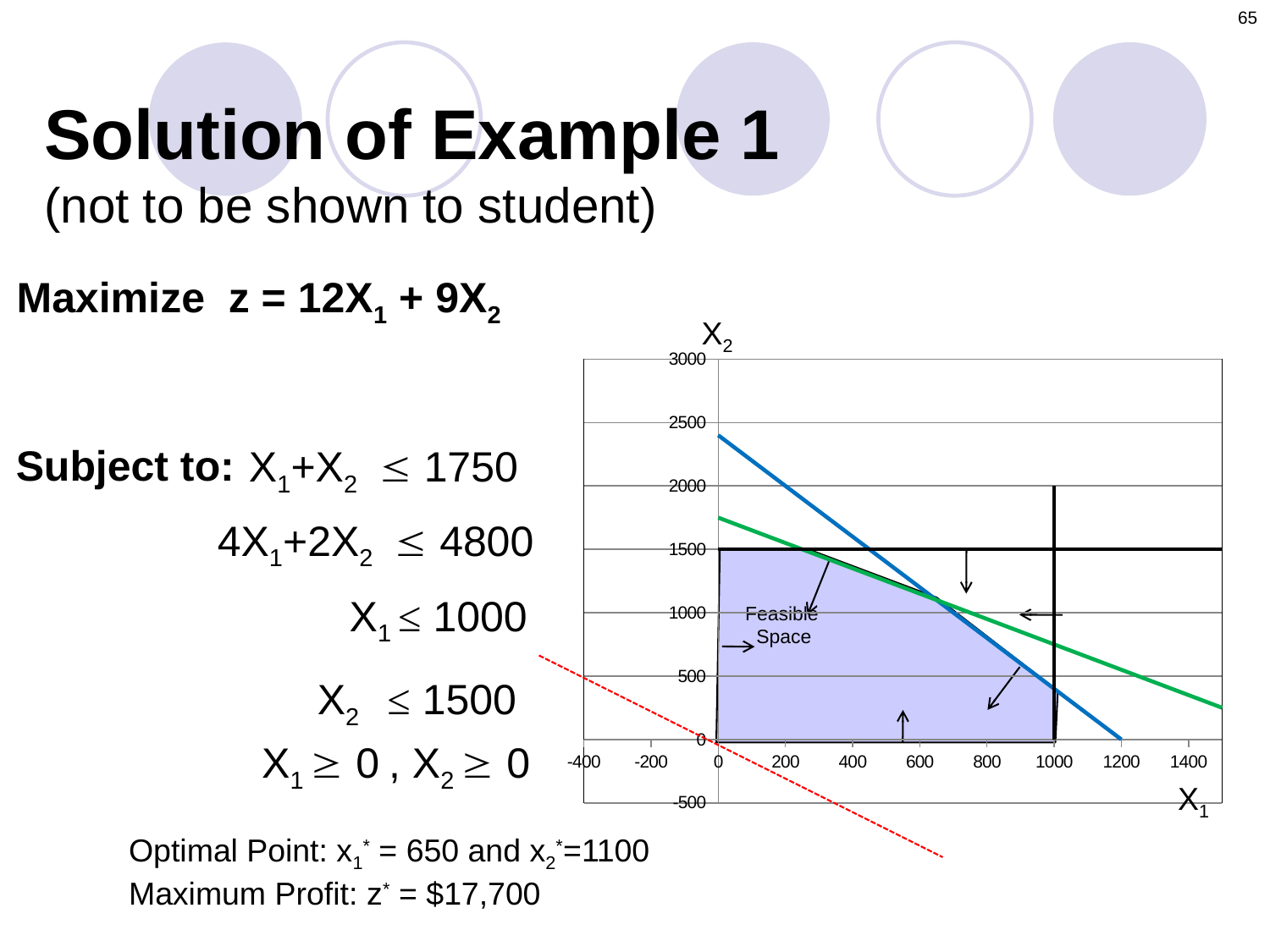
What is the highest tick value shown on the vertical axis of the chart? 3000 Which line meets the vertical axis at a higher X2 value, the blue line or the green line? blue line Does the blue line rise or fall as X1 increases along the horizontal axis? fall Is the X2 value where the blue line meets the vertical axis greater or less than 2000? greater What kind of chart is shown on the slide? line chart At what X2 value does the horizontal black constraint line sit on the chart? 1500 At what X1 value does the blue line cross the horizontal axis on the chart? 1200 Is the X2 value where the green line meets the vertical axis greater or less than 2000? less What is the label on the horizontal axis of the chart? X1 What is the label on the vertical axis of the chart? X2 What is the lowest tick value shown on the horizontal axis of the chart? -400 At what X1 value does the vertical black constraint line sit on the chart? 1000